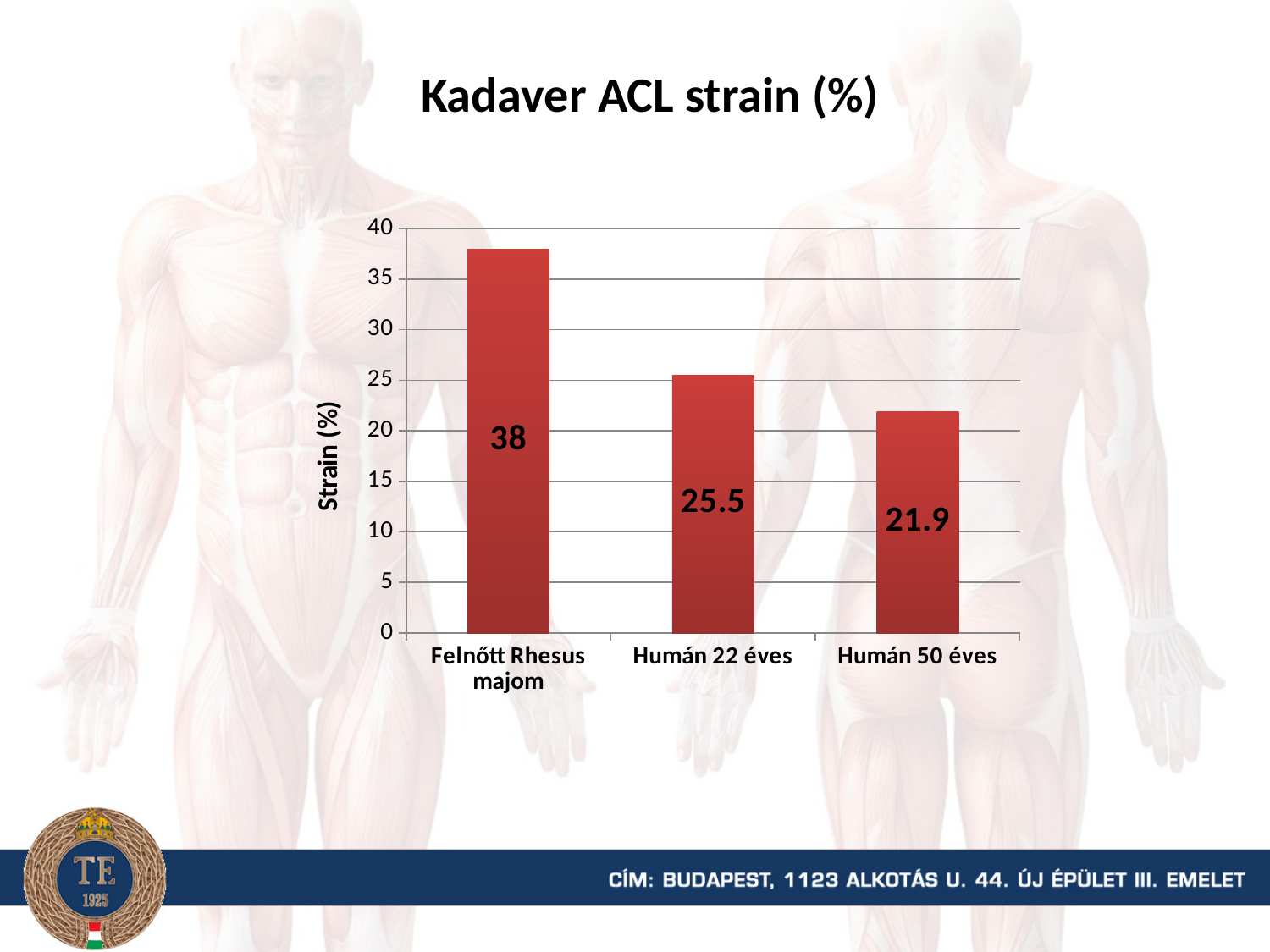
What is the strain value for Humán 22 éves? 25.5 What kind of chart is shown on the slide? bar chart What is the strain value for Humán 50 éves? 21.9 What is the difference between the strain values for Felnőtt Rhesus majom and Humán 22 éves? 12.5 How many categories are shown on the chart? 3 What is the strain value for Felnőtt Rhesus majom? 38 Is the value for Felnőtt Rhesus majom greater or less than 35? greater Which category has the lowest strain value? Humán 50 éves Which category has the highest strain value? Felnőtt Rhesus majom Which is larger, the strain value for Humán 22 éves or for Humán 50 éves? Humán 22 éves What is the difference between the strain values for Humán 22 éves and Humán 50 éves? 3.6 What is the title of the chart? Kadaver ACL strain (%)